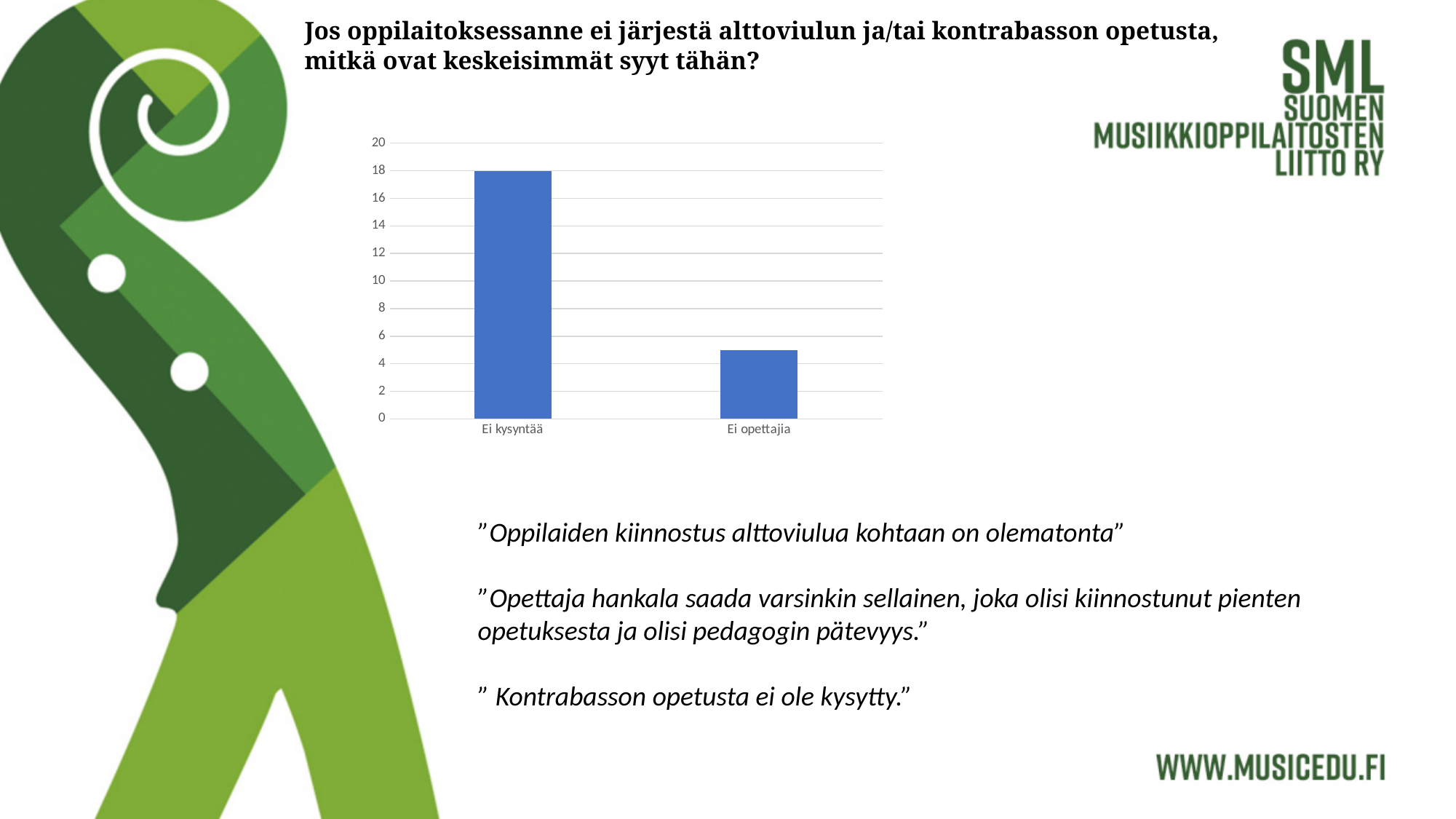
Is the value for Ei opettajia greater or less than 4? greater Which category has the highest value? Ei kysyntää What colour are the bars in the chart? blue Which is larger, the value for Ei kysyntää or the value for Ei opettajia? Ei kysyntää How many categories are shown on the x axis? 2 What kind of chart is shown on the slide? bar chart Which category has the lowest value? Ei opettajia What is the maximum value shown on the y axis? 20 Is the value for Ei opettajia greater or less than 10? less Is the value for Ei kysyntää greater or less than 16? greater What is the value for Ei kysyntää? 18